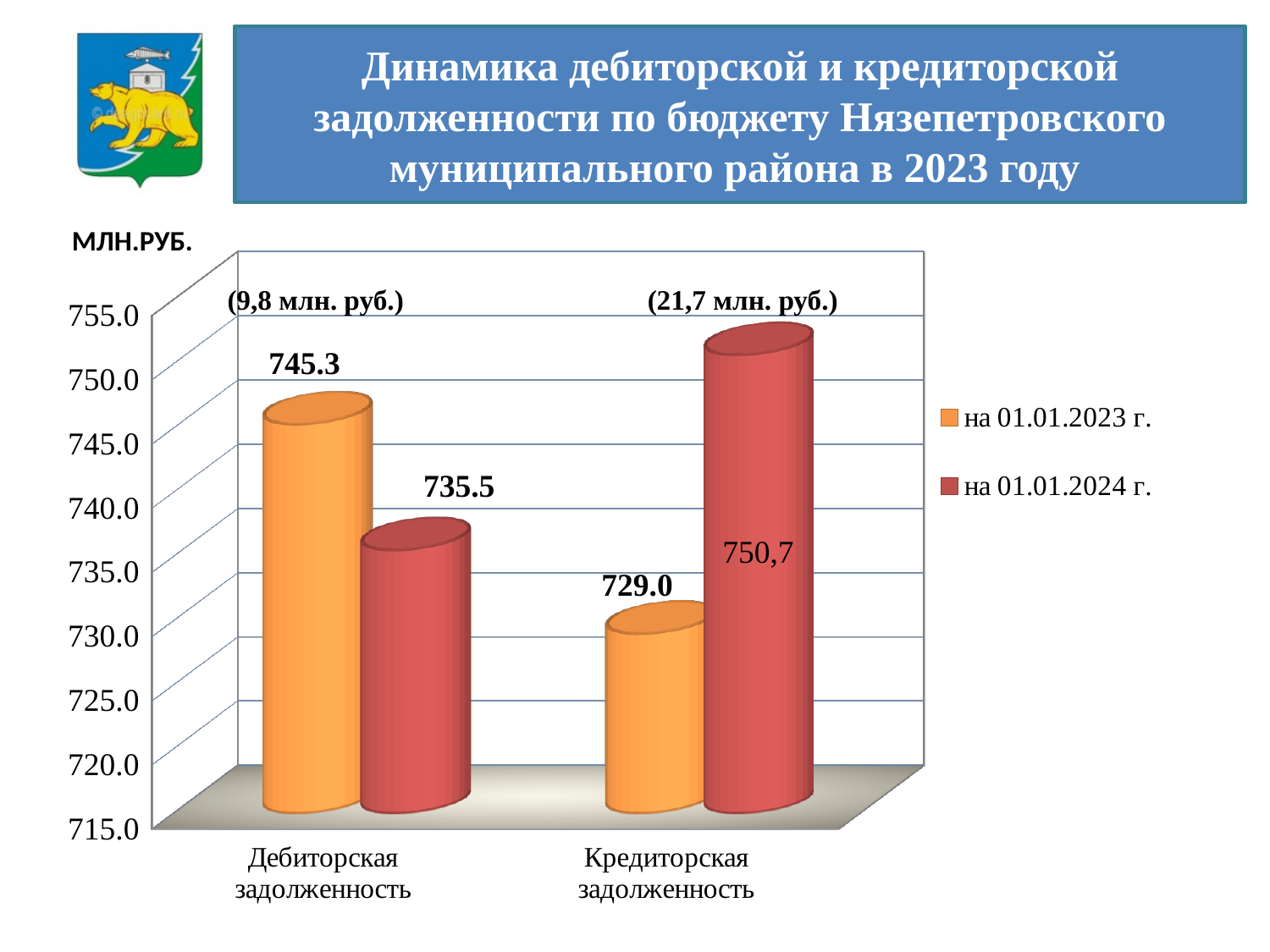
What is the value for Кредиторская задолженность in the series на 01.01.2024 г.? 750,7 What is the difference between the values for Дебиторская задолженность on 01.01.2023 г. and on 01.01.2024 г.? 9.8 Which category has the lowest value in the series на 01.01.2024 г.? Дебиторская задолженность What kind of chart is shown on the slide? bar chart What is the value for Дебиторская задолженность in the series на 01.01.2023 г.? 745.3 What is the value for Кредиторская задолженность in the series на 01.01.2023 г.? 729.0 Which category has the highest value in the series на 01.01.2023 г.? Дебиторская задолженность How many categories are shown on the x axis? 2 What is the value for Дебиторская задолженность in the series на 01.01.2024 г.? 735.5 What unit is indicated above the vertical axis of the chart? МЛН.РУБ. Which is larger for Кредиторская задолженность: the value on 01.01.2023 г. or on 01.01.2024 г.? на 01.01.2024 г. How many series does the legend list? 2